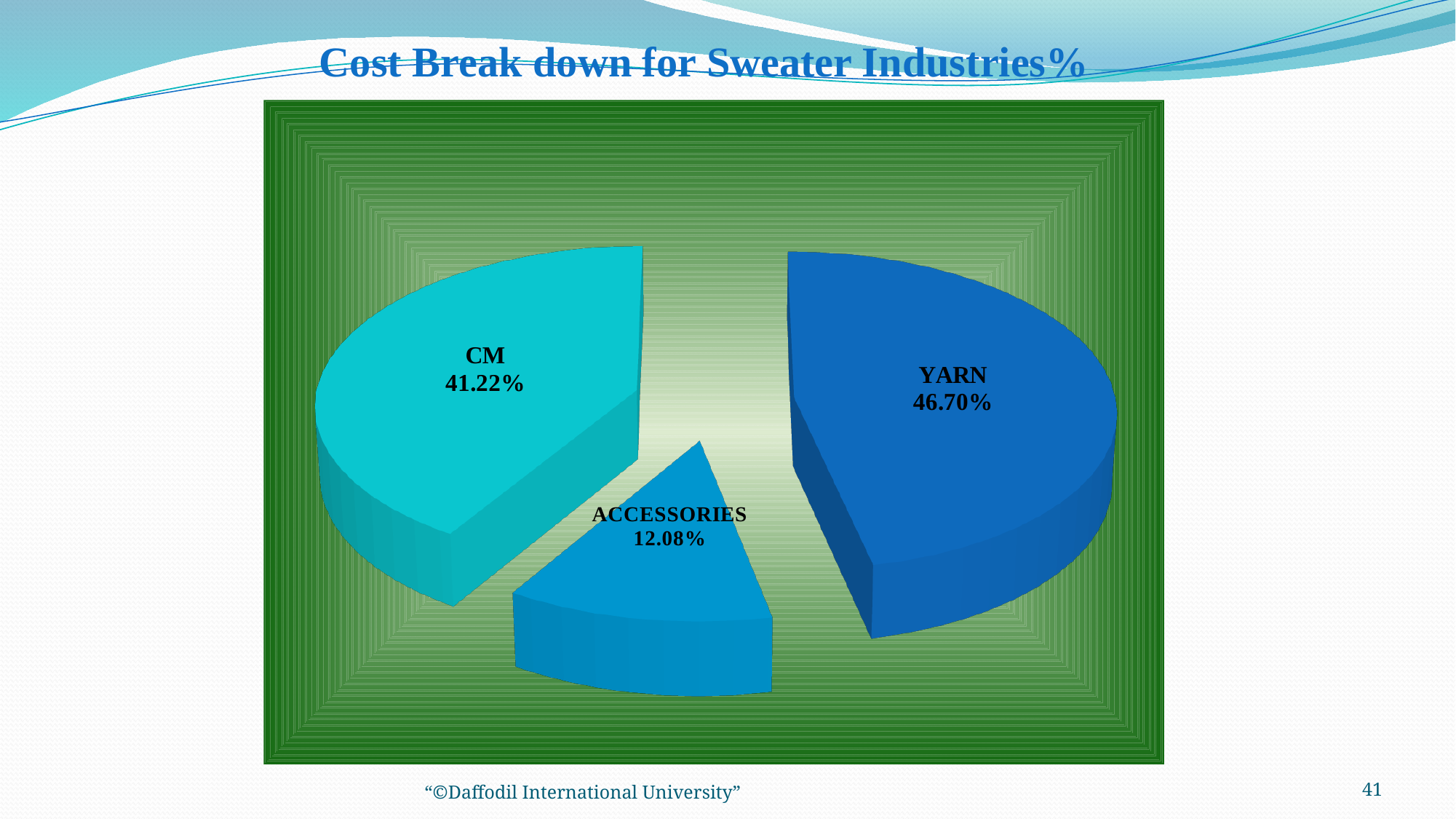
How many categories are shown in the pie chart? 3 What kind of chart is shown on the slide? Pie chart What is the difference in percentage points between CM and ACCESSORIES? 29.14 Which category has the smallest share of the cost breakdown? ACCESSORIES What is the difference in percentage points between YARN and CM? 5.48 What is the title of the chart? Cost Break down for Sweater Industries% What percentage of the cost breakdown is ACCESSORIES? 12.08% Which is larger, the share for YARN or the share for CM? YARN What percentage of the cost breakdown is CM? 41.22% What colour is the CM slice of the pie chart? Cyan (turquoise) Which category has the largest share of the cost breakdown? YARN What percentage of the cost breakdown is YARN? 46.70%